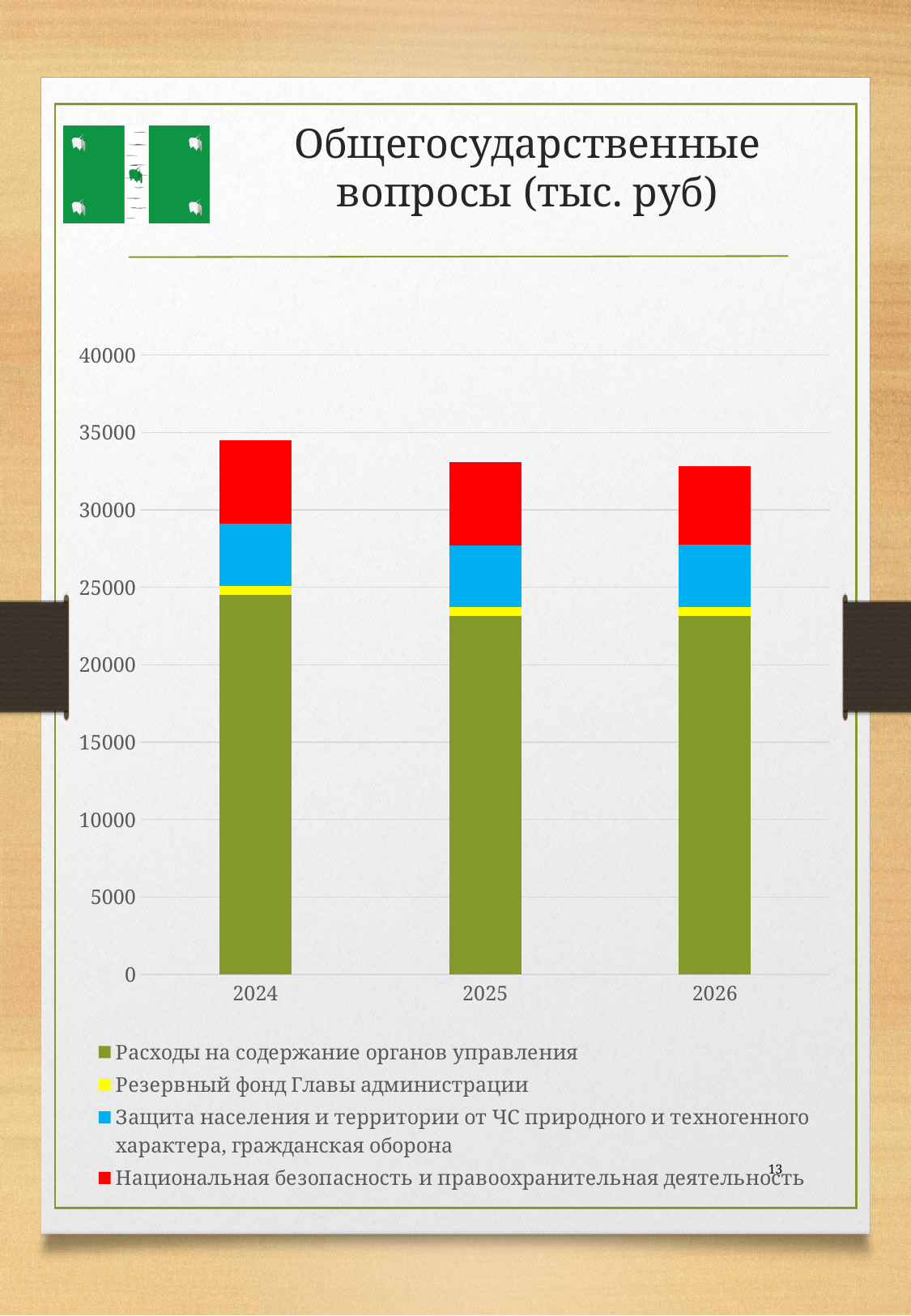
Is the total stacked bar for 2025 greater or less than 30000? greater How many years are shown on the x axis of the chart? 3 Is the value for 'Расходы на содержание органов управления' in 2024 greater or less than 20000? greater Which year has the tallest stacked bar in total? 2024 Is the total stacked bar for 2026 greater or less than 35000? less Which colour represents 'Национальная безопасность и правоохранительная деятельность' in the chart? red How many series does the chart legend list? 4 Do the total stacked bar heights rise or fall from 2024 to 2026? fall What is the title of the chart? Общегосударственные вопросы (тыс. руб) What kind of chart is shown on the slide? stacked bar chart